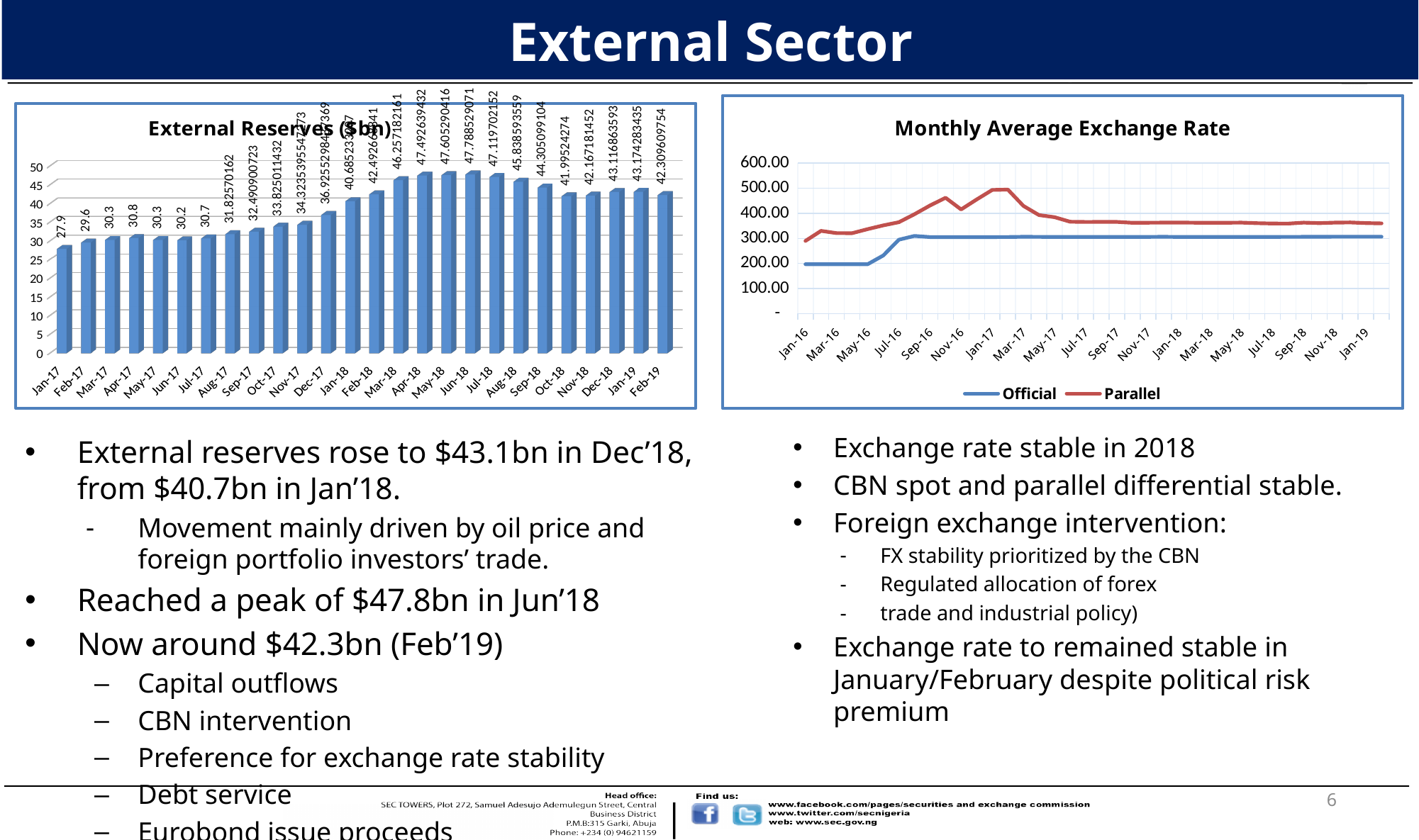
In the 'Monthly Average Exchange Rate' chart, is the Parallel rate in Jan-17 greater or less than 400.00? greater What kind of chart is the 'Monthly Average Exchange Rate' chart? line chart What kind of chart is the 'External Reserves ($bn)' chart? bar chart In the 'Monthly Average Exchange Rate' chart, how many series does the legend list? 2 In the 'External Reserves ($bn)' chart, what is the value for Jan-17? 27.9 In the 'External Reserves ($bn)' chart, what is the difference between the values for Feb-17 and Jan-17? 1.7 In the 'External Reserves ($bn)' chart, what is the value for Jun-18? 47.788529071 In the 'External Reserves ($bn)' chart, how many months (bars) are plotted? 26 In the 'External Reserves ($bn)' chart, what is the value for Feb-19? 42.309609754 In the 'External Reserves ($bn)' chart, which month has the lowest value? Jan-17 In the 'Monthly Average Exchange Rate' chart, what are the two series named in the legend? Official and Parallel In the 'External Reserves ($bn)' chart, which month has the highest value? Jun-18